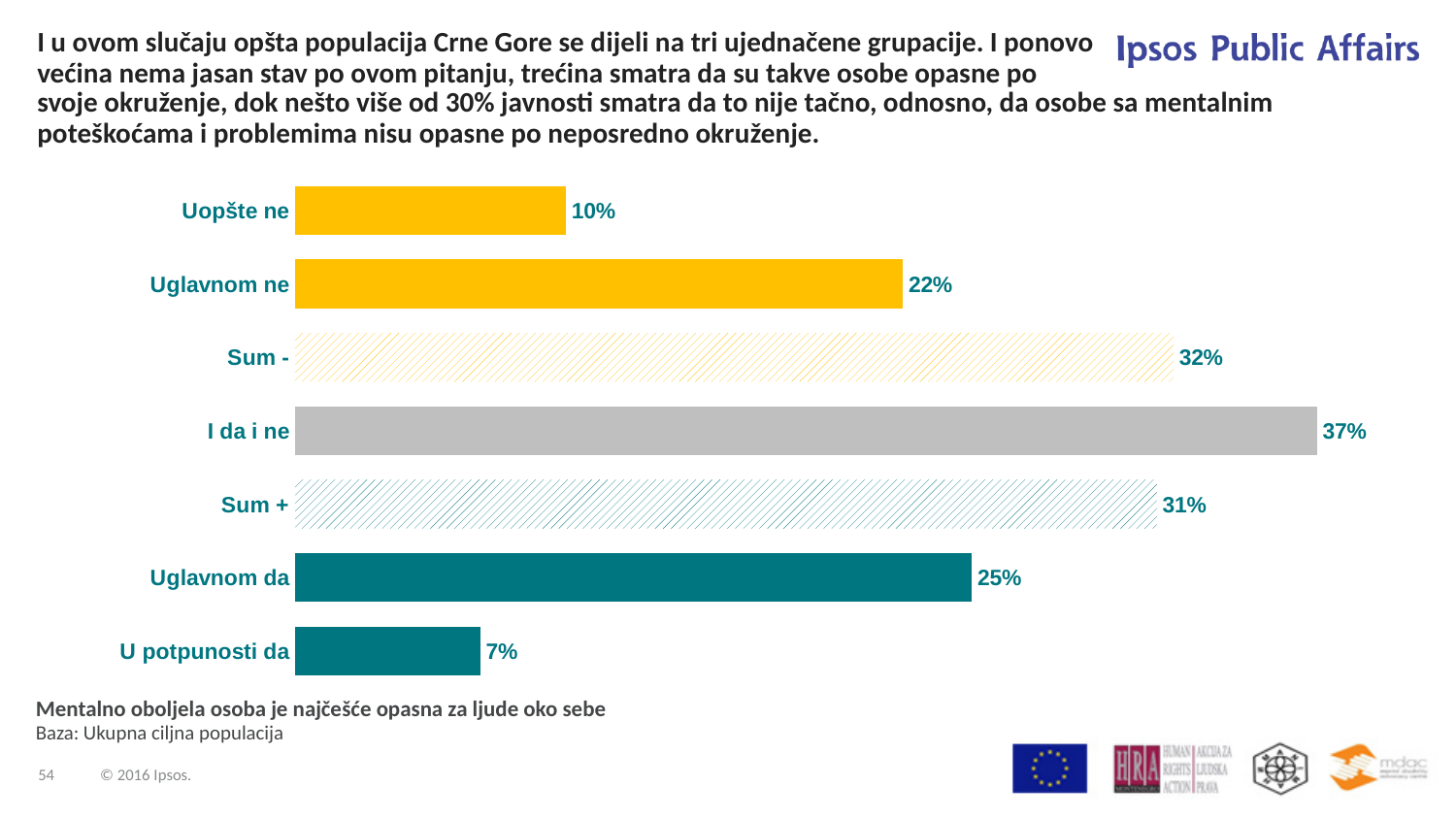
What is the difference between "Uglavnom da" and "Uglavnom ne"? 3% Which category has the highest value? I da i ne What is the value for "I da i ne"? 37% Which category has the lowest value? U potpunosti da How many bars are shown in the chart? 7 What is the value for "Uglavnom da"? 25% What is the value for "Uglavnom ne"? 22% What is the difference between "Sum -" and "Sum +"? 1% What is the value for "Uopšte ne"? 10% Which is larger, "Uglavnom ne" or "Uglavnom da"? Uglavnom da What is the value for "U potpunosti da"? 7% What kind of chart is shown on the slide? Bar chart